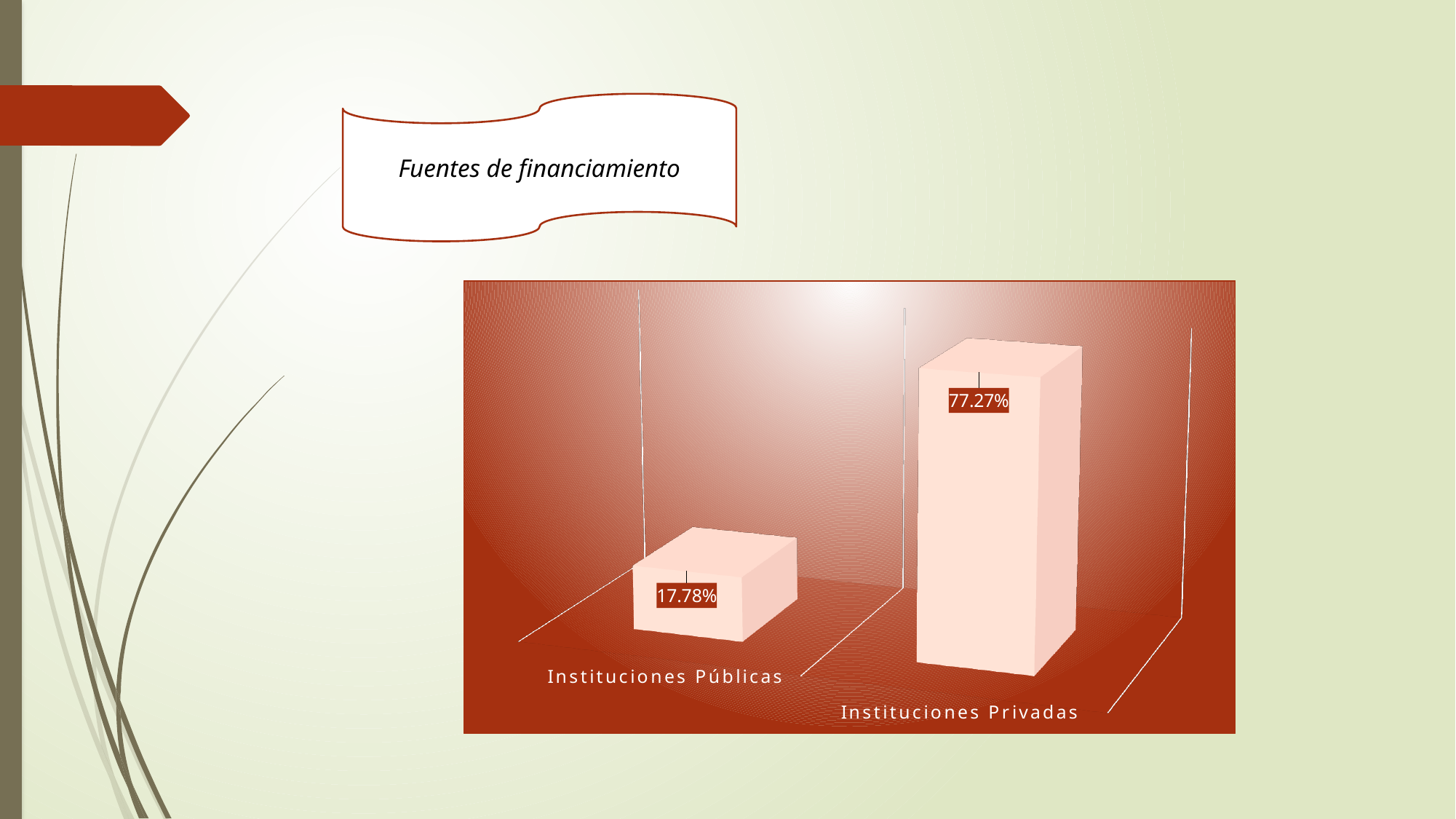
What is the difference between the values for Instituciones Privadas and Instituciones Públicas? 59.49% What kind of chart is shown on the slide? Bar chart Which category has the highest value? Instituciones Privadas How many categories are shown in the chart? 2 What is the total of the two values shown in the chart? 95.05% What is the value for Instituciones Públicas? 17.78% What is the title shown in the banner above the chart? Fuentes de financiamiento What is the value for Instituciones Privadas? 77.27% Which category has the lowest value? Instituciones Públicas Which is larger, the value for Instituciones Públicas or Instituciones Privadas? Instituciones Privadas